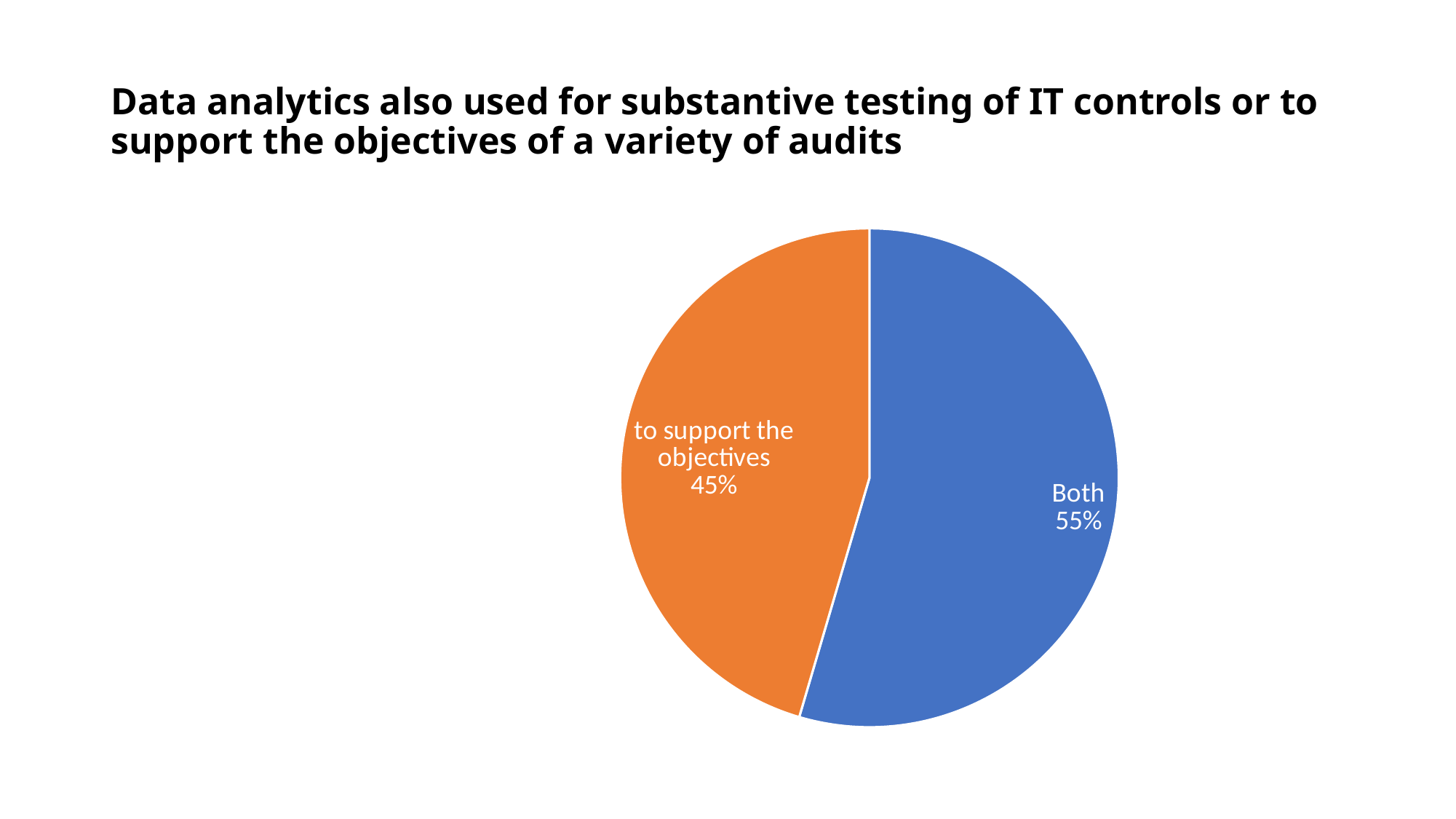
Which slice is the smallest in the pie chart? to support the objectives Which is larger: the "Both" slice or the "to support the objectives" slice? Both What colour is the "to support the objectives" slice? orange Which slice is the largest in the pie chart? Both What is the difference in percentage points between the "Both" slice and the "to support the objectives" slice? 10 What colour is the "Both" slice? blue What share of the pie does the "Both" slice represent? 55% What share of the pie does the "to support the objectives" slice represent? 45% Is the share for "to support the objectives" greater or less than 50%? less What kind of chart is shown on the slide? pie chart Is the share for "Both" greater or less than 50%? greater How many slices does the pie chart have? 2